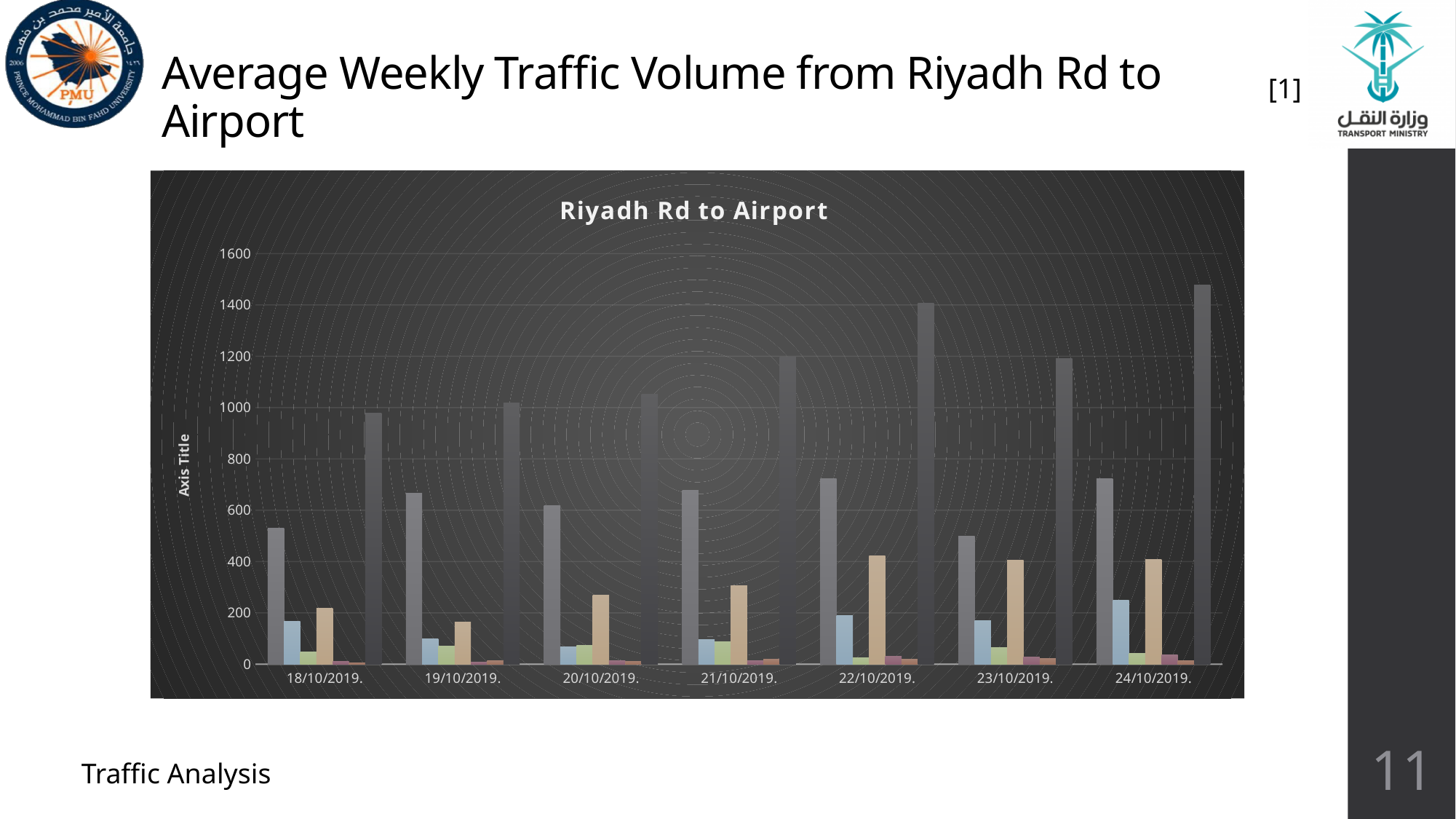
What is the highest tick value shown on the vertical axis? 1600 What is the label on the vertical axis of the chart? Axis Title Which date has the tallest bar in the whole chart? 24/10/2019. Is the tallest bar in the 22/10/2019 group greater or less than 1200? greater Which group has the taller tallest bar, 22/10/2019 or 23/10/2019? 22/10/2019. What kind of chart is shown on the slide? bar chart Is the tallest bar in the 18/10/2019 group greater or less than 800? greater Is the tallest bar in the 21/10/2019 group greater or less than 1000? greater Which group has the taller tallest bar, 18/10/2019 or 24/10/2019? 24/10/2019. What is the title of the chart? Riyadh Rd to Airport How many dates are shown along the x axis of the chart? 7